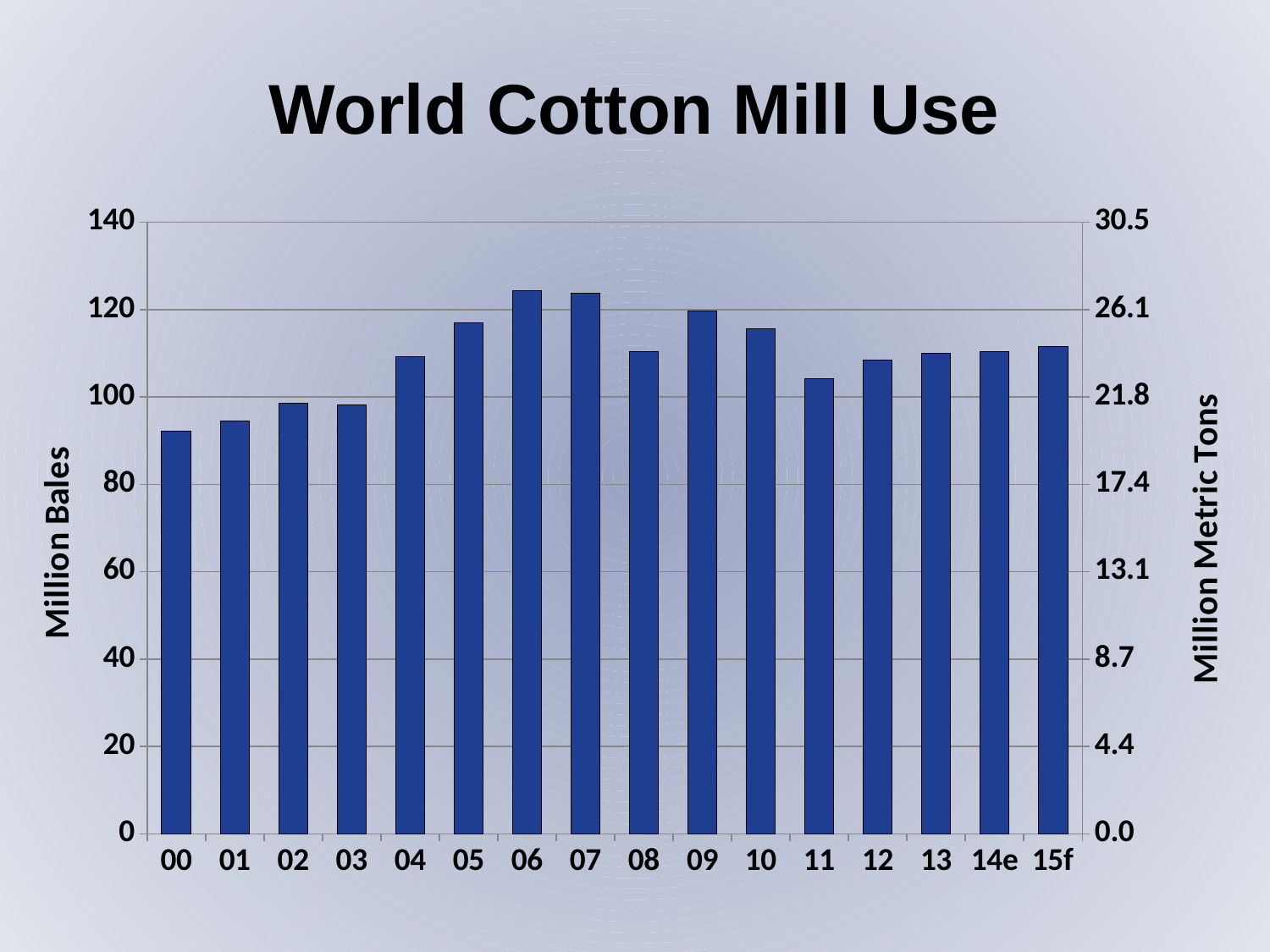
How many bars (years) are plotted in the chart? 16 Is the value for 11 greater or less than 100 million bales? greater Is the value for 06 greater or less than 120 million bales? greater Which is larger, the value for 09 or the value for 11? 09 What is the label of the left vertical axis? Million Bales What is the title of the chart? World Cotton Mill Use Is the value for 05 greater or less than 120 million bales? less What kind of chart is shown on the slide? bar chart Which is larger, the value for 04 or the value for 05? 05 Do the values rise or fall from 00 to 06? rise Which year has the lowest cotton mill use? 00